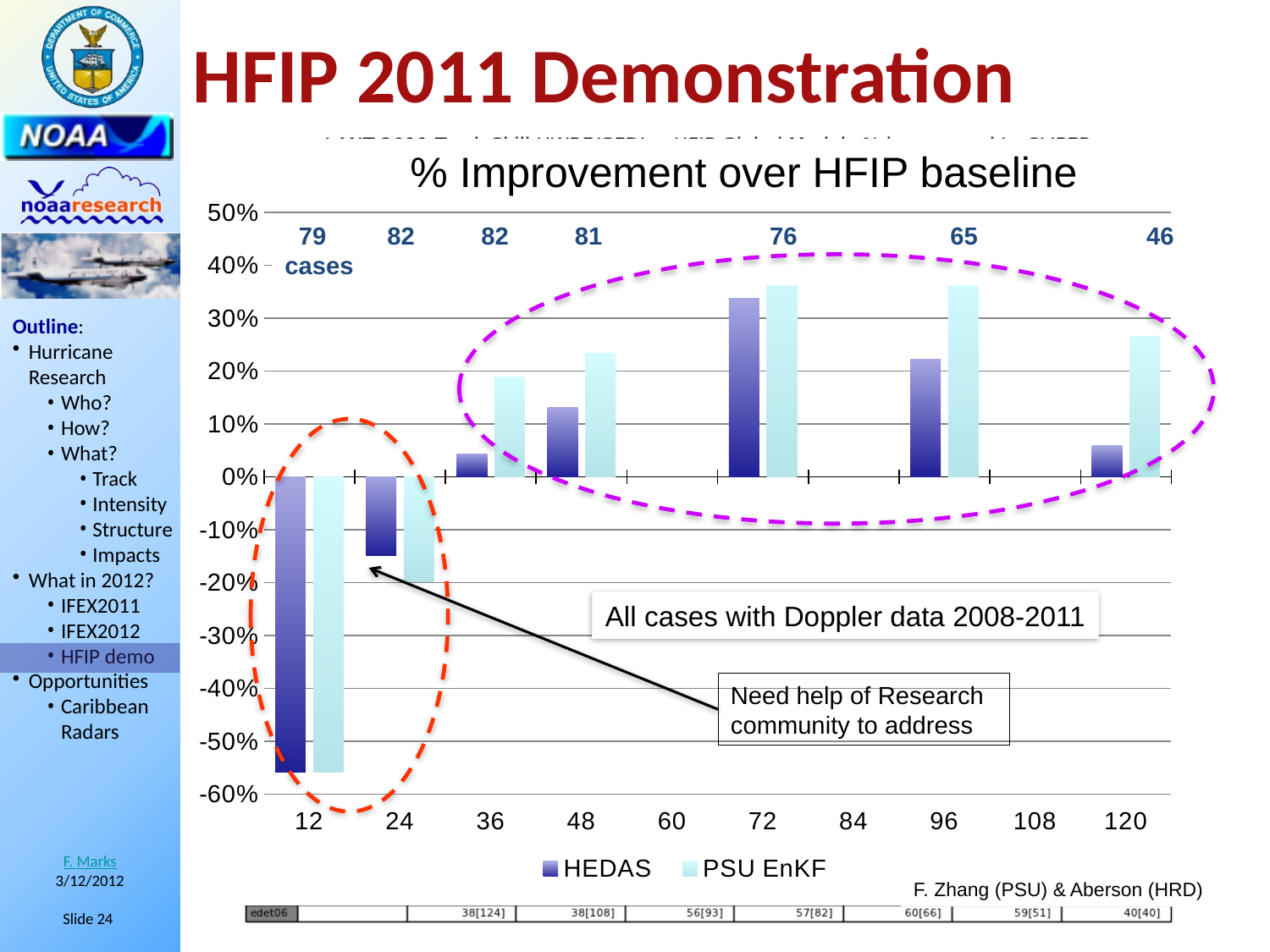
At which x-axis value does PSU EnKF have its lowest value? 12 What is the title of the chart? % Improvement over HFIP baseline What type of chart is shown on the slide? bar chart How many series does the legend list? 2 Is the HEDAS value at 120 greater or less than 10%? less Is the HEDAS value at 12 greater or less than -50%? less At 96, which series has the larger value, HEDAS or PSU EnKF? PSU EnKF What are the two series named in the legend? HEDAS and PSU EnKF How many cases are listed above the 72 position on the x axis? 76 Is the PSU EnKF value at 96 greater or less than 30%? greater At which x-axis value does HEDAS reach its highest value? 72